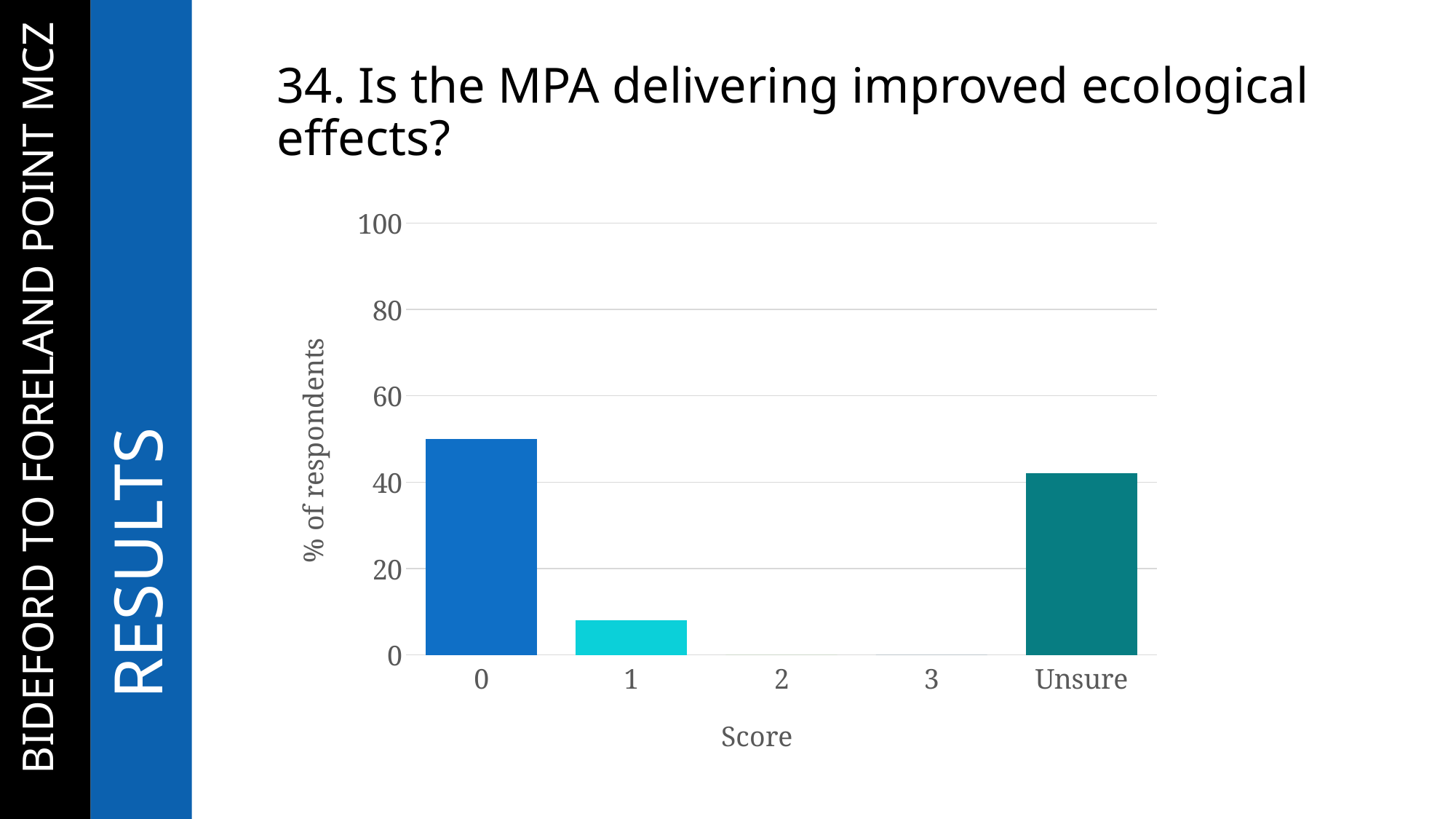
What kind of chart is shown on the slide? bar chart Which score category has the highest percentage of respondents? 0 Is the value for Unsure greater or less than 60? less Which is larger, the value for score 0 or the value for Unsure? 0 Is the value for Unsure greater or less than 40? greater Is the value for score 0 greater or less than 60? less Which is larger, the value for score 1 or the value for Unsure? Unsure What is the label of the y axis? % of respondents How many score categories are shown on the x axis? 5 What is the label of the x axis? Score